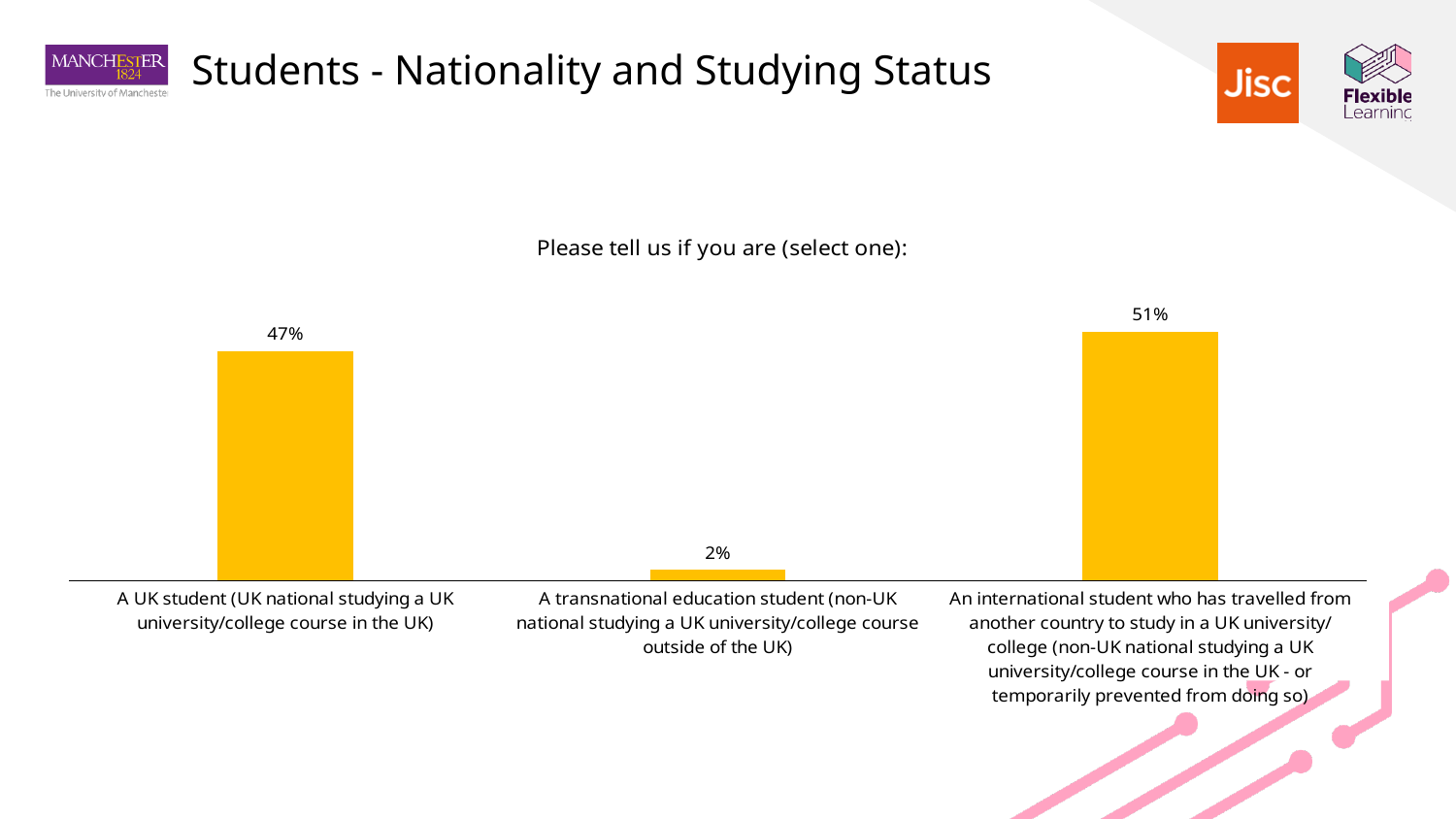
Which category has the lowest percentage? A transnational education student Which is larger: the percentage of UK students or the percentage of international students? International students What colour are the bars in the chart? Yellow What type of chart is shown on the slide? Bar chart What is the title of the chart? Please tell us if you are (select one): Which category has the highest percentage? An international student who has travelled from another country to study in a UK university/college What percentage of respondents are an international student who has travelled from another country to study in a UK university/college? 51% What percentage of respondents are a transnational education student? 2% What is the difference in percentage points between UK students and transnational education students? 45 How many categories are shown in the chart? 3 What percentage of respondents are a UK student (UK national studying a UK university/college course in the UK)? 47% What is the difference in percentage points between international students and UK students? 4